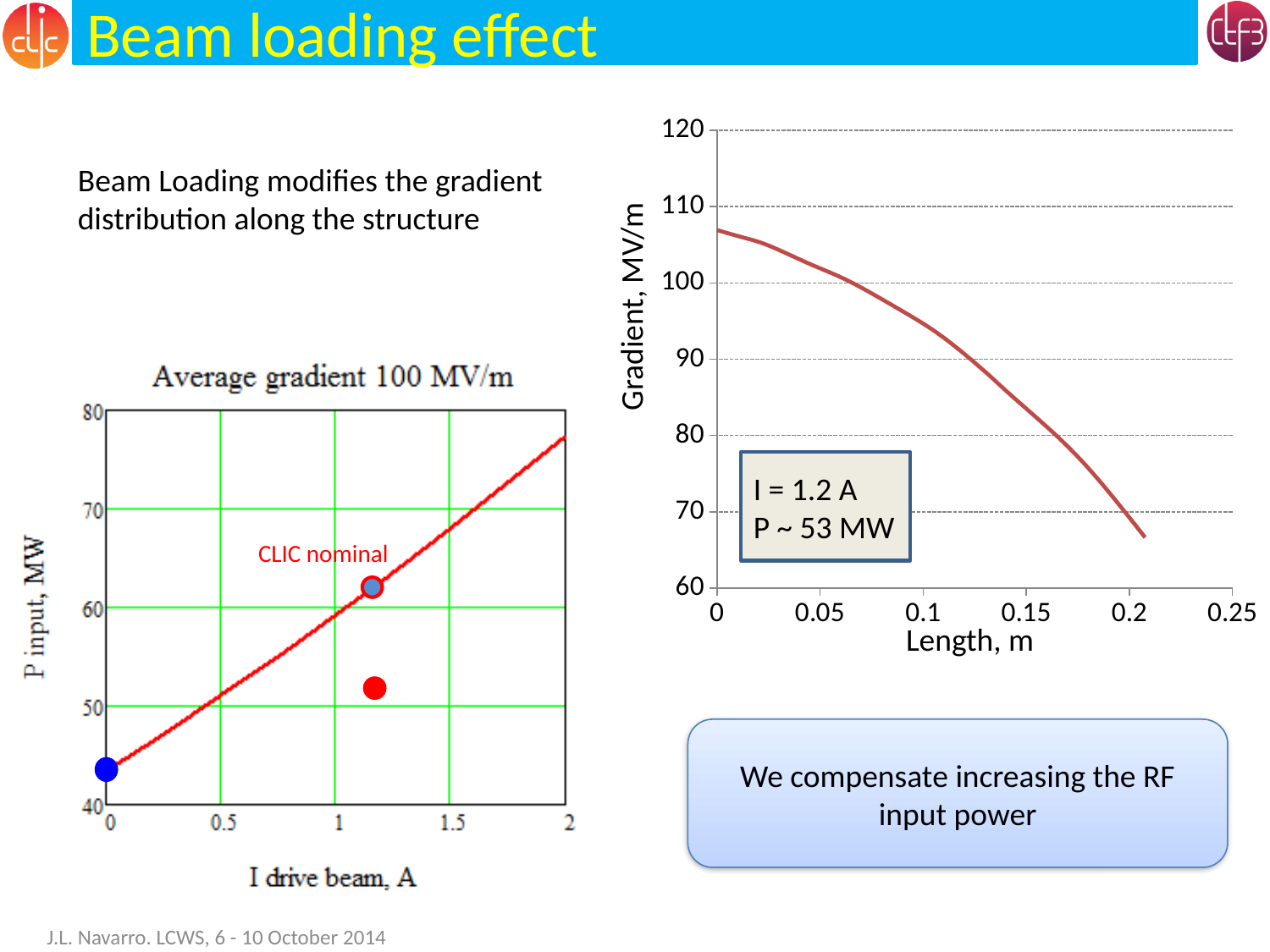
In the chart on the left, is the P input of the CLIC nominal point greater or less than 60 MW? greater What type of chart is the chart on the right (Gradient vs Length)? line chart What is the y-axis label of the chart on the right? Gradient, MV/m In the chart on the right, is the gradient at length 0.1 m greater or less than 90 MV/m? greater In the chart on the left, is the P input of the red dot below the line greater or less than 60 MW? less In the chart on the left, does P input rise or fall as I drive beam increases? rise What is the title of the chart on the left? Average gradient 100 MV/m What drive beam current is stated in the annotation box on the right chart? I = 1.2 A In the chart on the right, does the gradient rise or fall as length increases? fall